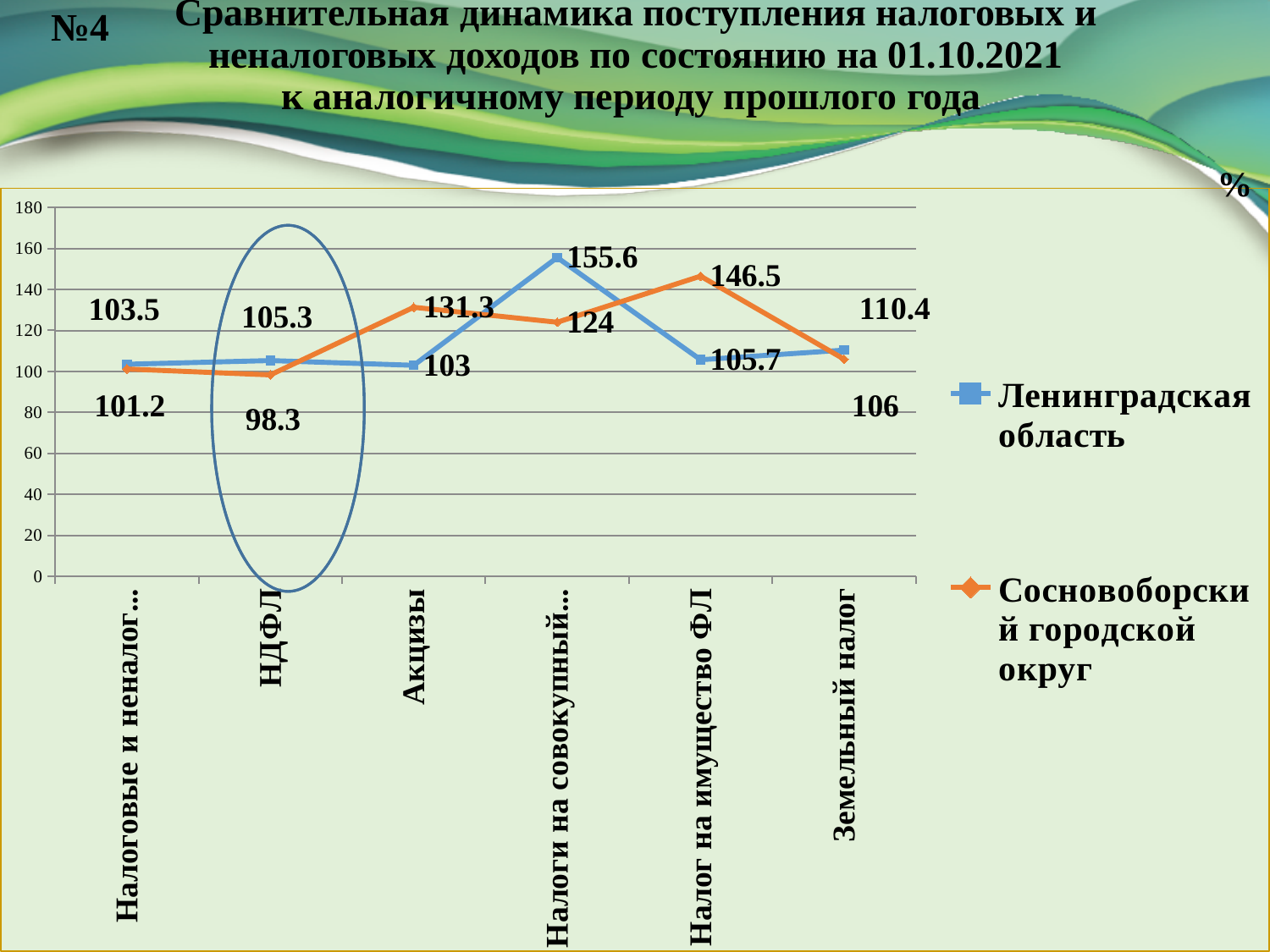
What is the value for Сосновоборский городской округ for НДФЛ? 98.3 What kind of chart is shown on the slide? line chart What is the value for Ленинградская область for НДФЛ? 105.3 Which series is drawn in orange? Сосновоборский городской округ What is the value for Сосновоборский городской округ for Акцизы? 131.3 For Земельный налог, which series has the larger value? Ленинградская область How many categories are shown on the x axis? 6 For which category is the Сосновоборский городской округ value lowest? НДФЛ For which category is the Ленинградская область value highest? Налоги на совокупный... What is the value for Ленинградская область for Налог на имущество ФЛ? 105.7 What is the difference between the Сосновоборский городской округ and Ленинградская область values for Налог на имущество ФЛ? 40.8 How many series does the legend list? 2